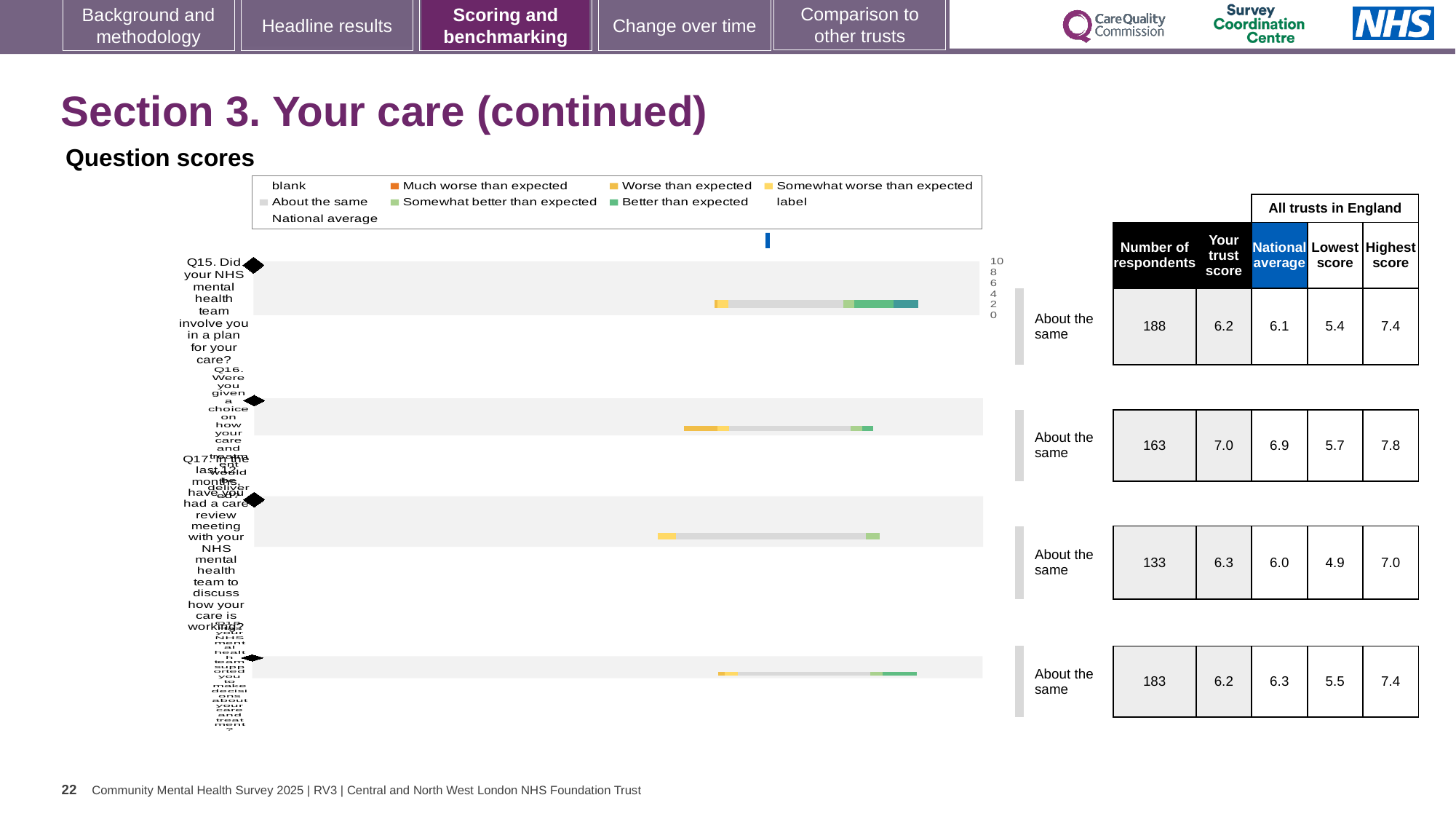
Which question has the lowest 'Lowest score' value in the Question scores table? Q17 What is the National average for Q17 in the Question scores table? 6.0 What benchmark category is shown next to the Q15 bar in the Question scores chart? About the same What kind of chart is used to show the question scores on this slide? bar chart What is the difference between the Highest score and the Lowest score for Q16? 2.1 How many respondents are recorded for Q16 in the Question scores table? 163 What is the title of the chart on this slide? Question scores How many questions (bars) are plotted in the Question scores chart? 4 How many entries does the legend of the Question scores chart list? 9 What is the 'Your trust score' value for Q15 in the Question scores table? 6.2 For Q15, which is larger: the trust score or the National average? Your trust score Which question has the highest 'Your trust score' in the Question scores table? Q16